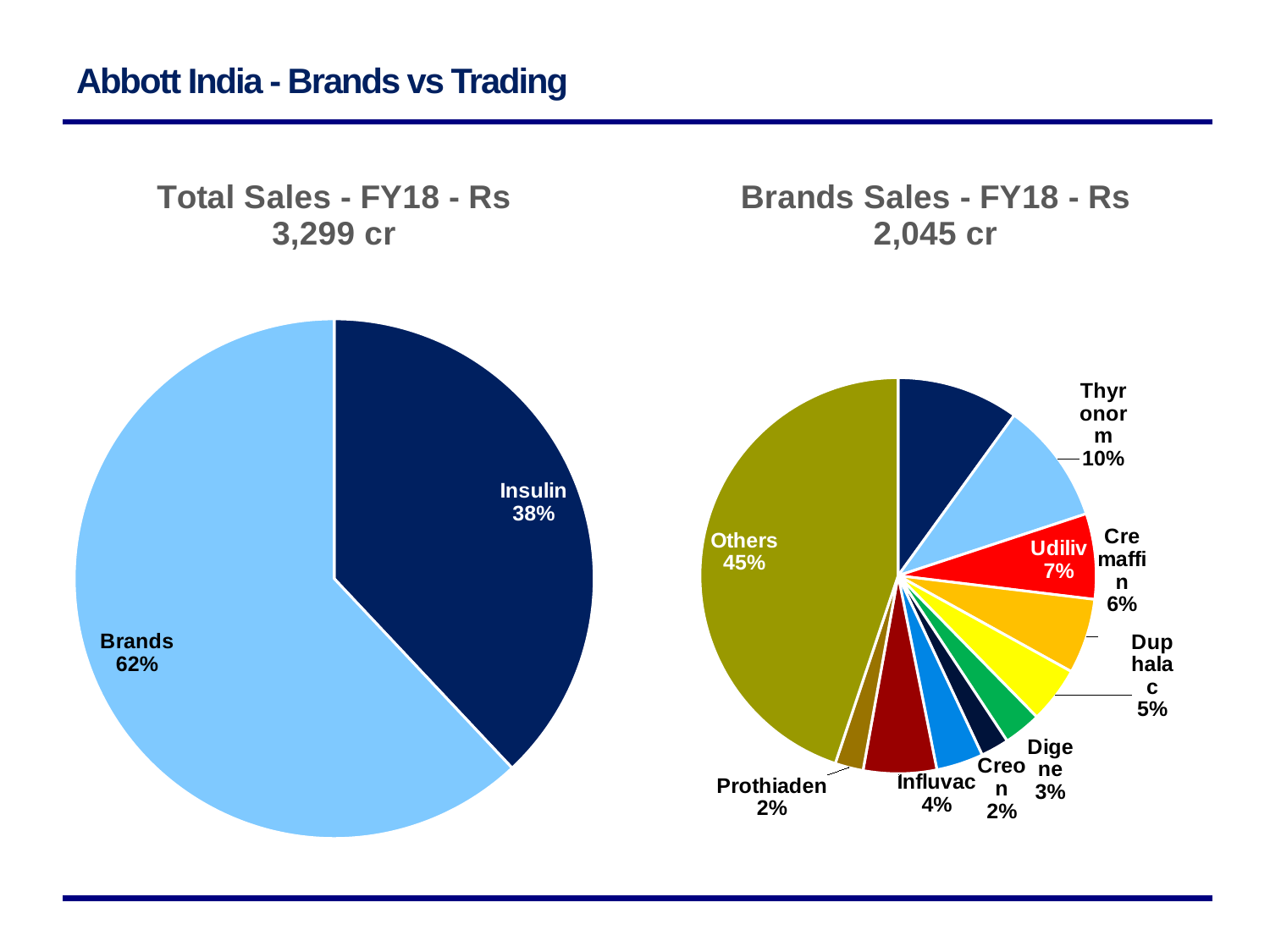
In the Total Sales - FY18 pie chart, what is the difference in percentage points between Brands and Insulin? 24 percentage points In the Brands Sales - FY18 pie chart, what is the difference in percentage points between Cremaffin and Duphalac? 1 percentage point In the Brands Sales - FY18 pie chart, what share does Udiliv have? 7% In the Total Sales - FY18 pie chart, what share of sales is Insulin? 38% In the Total Sales - FY18 pie chart, what share of sales is Brands? 62% How many slices does the Total Sales - FY18 pie chart have? 2 In the Brands Sales - FY18 pie chart, which is larger, Influvac or Digene? Influvac What type of chart is used for Brands Sales - FY18? Pie chart In the Total Sales - FY18 pie chart, which segment is larger, Brands or Insulin? Brands In the Brands Sales - FY18 pie chart, which labelled segment has the largest share? Others In the Brands Sales - FY18 pie chart, what share does Thyronorm have? 10% What total sales figure is given in the title of the left pie chart? Rs 3,299 cr